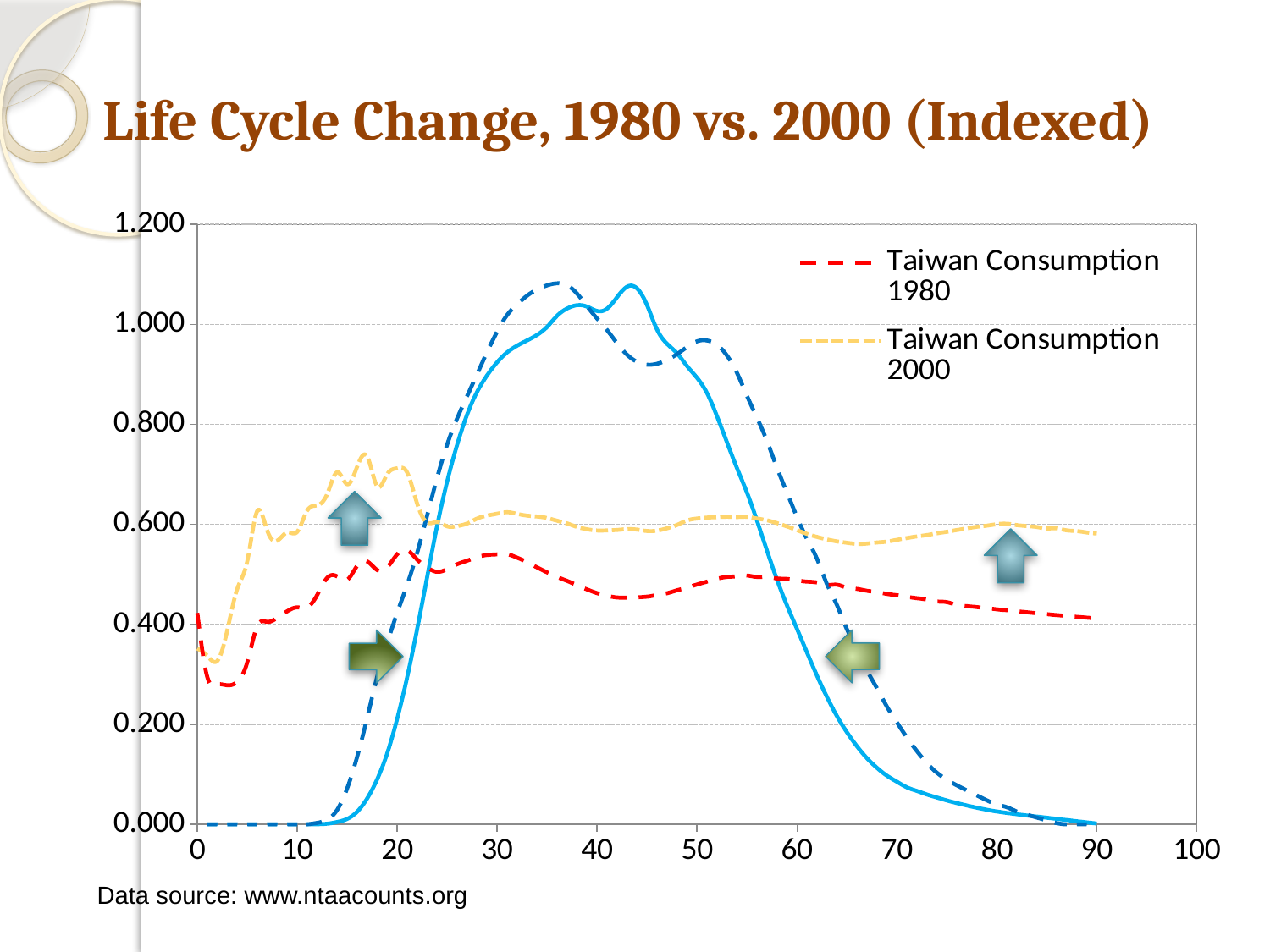
Is the value for Taiwan Consumption 1980 at age 30 greater or less than 0.400? greater What colour is the Taiwan Consumption 1980 line in the legend? red At age 10, which is higher: Taiwan Consumption 1980 or Taiwan Consumption 2000? Taiwan Consumption 2000 Is the value for Taiwan Consumption 2000 at age 70 greater or less than 0.800? less Is the value for Taiwan Consumption 1980 at age 2 greater or less than 0.400? less At age 80, which is higher: Taiwan Consumption 1980 or Taiwan Consumption 2000? Taiwan Consumption 2000 How many series does the chart legend list? 2 What kind of chart is shown on the slide? line chart What is the title of the slide's chart? Life Cycle Change, 1980 vs. 2000 (Indexed) Does the Taiwan Consumption 1980 line rise or fall between age 60 and age 90? fall Does the Taiwan Consumption 2000 line rise or fall between age 0 and age 20? rise